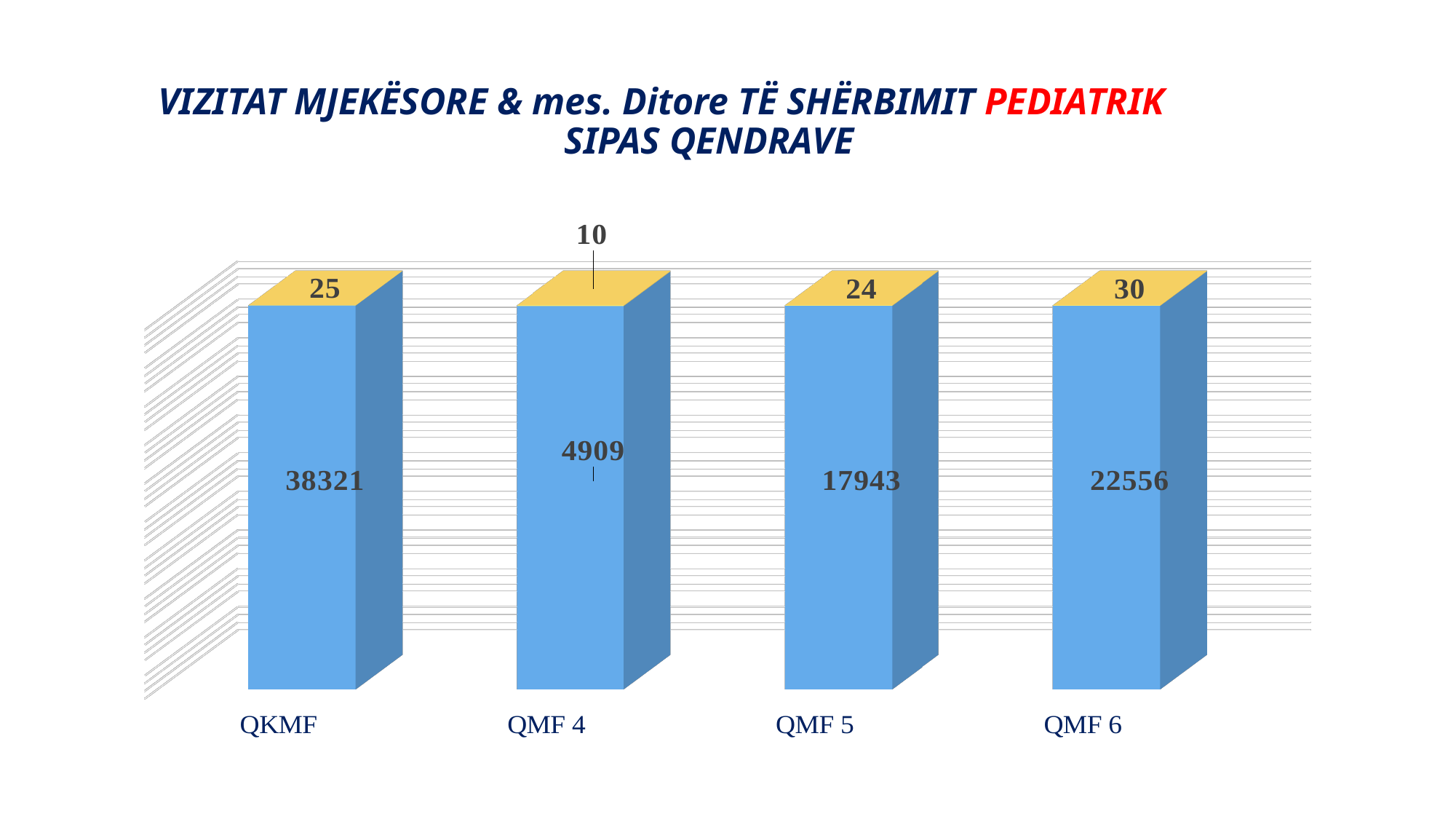
Which centre has the highest value printed on its blue segment? QKMF What is the value printed on the blue segment of the QKMF bar? 38321 What is the difference between the blue-segment values of QKMF and QMF 4? 33412 Which centre has the lowest value printed on its yellow segment? QMF 4 What colour is the top segment of each bar? Yellow What kind of chart is shown on the slide? Bar chart What is the value printed on the blue segment of the QMF 4 bar? 4909 What is the value printed on the yellow segment of the QMF 6 bar? 30 How many centres are shown on the x axis? 4 What is the value printed on the yellow segment of the QMF 5 bar? 24 Which has a larger yellow-segment value, QKMF or QMF 6? QMF 6 What is the difference between the blue-segment values of QMF 6 and QMF 5? 4613